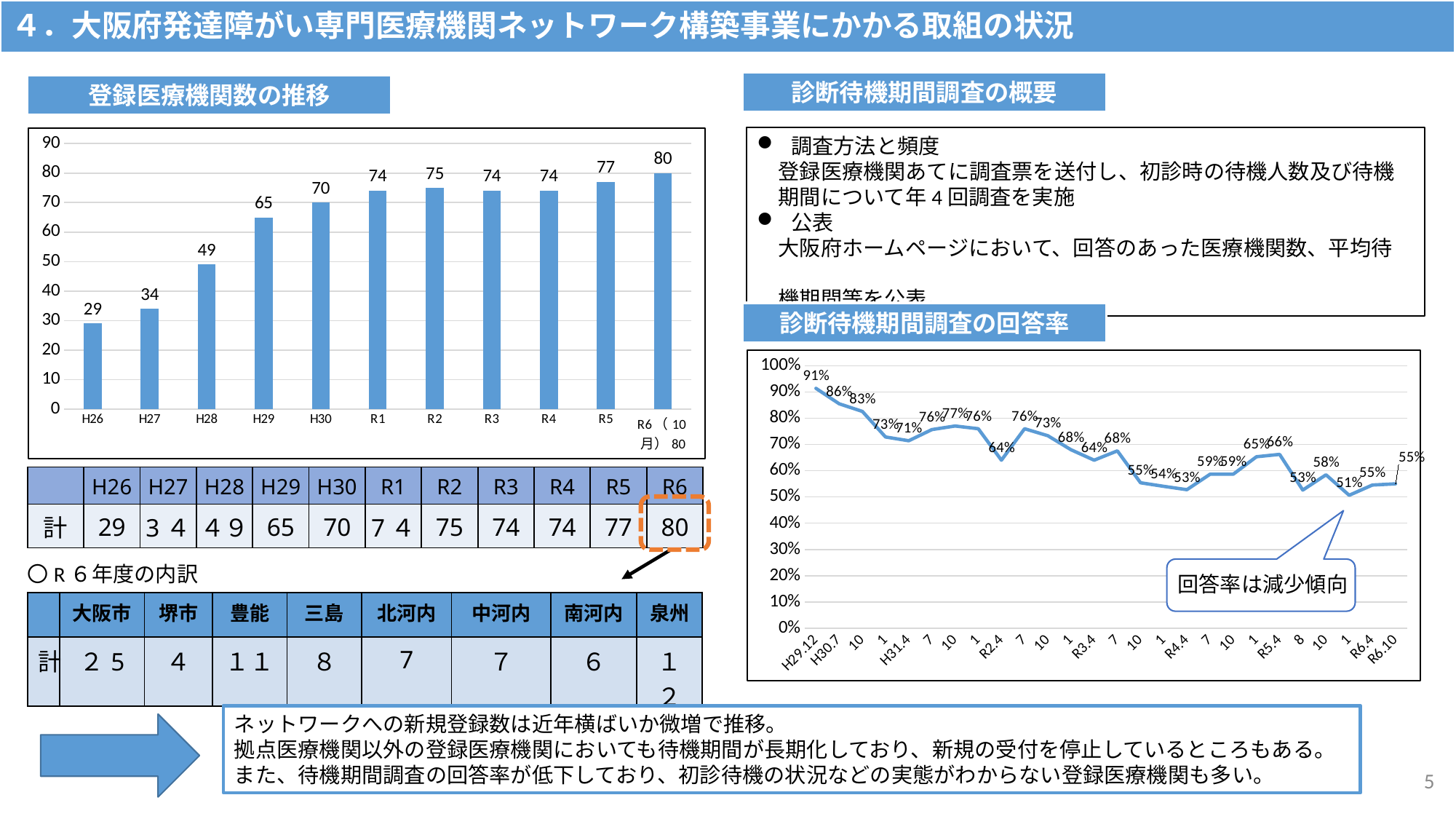
In the bar chart 登録医療機関数の推移, which is larger, the value for H30 or the value for R2? R2 In the bar chart 登録医療機関数の推移, which category has the lowest value? H26 In the bar chart 登録医療機関数の推移, what is the value for R5? 77 In the bar chart 登録医療機関数の推移, what is the difference between the values for H28 and H27? 15 In the line chart 診断待機期間調査の回答率, what is the value at R6.4? 55% How many bars are shown in the bar chart 登録医療機関数の推移? 11 In the bar chart 登録医療機関数の推移, which category has the highest value? R6（10月） What kind of chart is 診断待機期間調査の回答率? line chart What kind of chart is 登録医療機関数の推移? bar chart In the line chart 診断待機期間調査の回答率, what is the value at H29.12? 91% In the line chart 診断待機期間調査の回答率, do the values generally rise or fall from left to right? fall In the bar chart 登録医療機関数の推移, what is the value for H29? 65